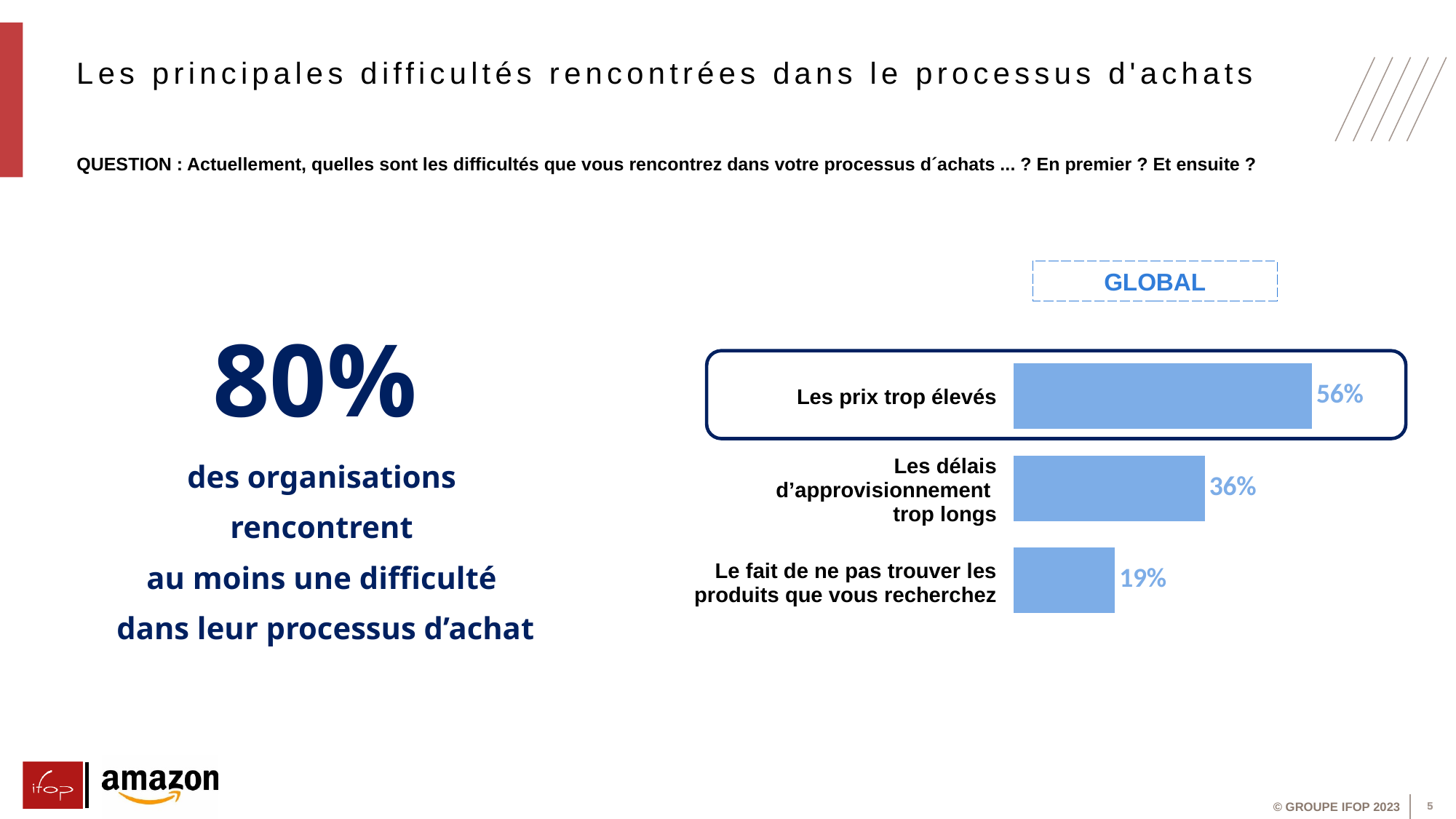
What is the value for "Les prix trop élevés"? 56% What is the value for "Le fait de ne pas trouver les produits que vous recherchez"? 19% What is the difference between the values for "Les prix trop élevés" and "Les délais d'approvisionnement trop longs"? 20% Which category has the lowest value? Le fait de ne pas trouver les produits que vous recherchez What kind of chart is shown on the slide? Bar chart What is the value for "Les délais d'approvisionnement trop longs"? 36% Which is larger: the value for "Les délais d'approvisionnement trop longs" or for "Le fait de ne pas trouver les produits que vous recherchez"? Les délais d'approvisionnement trop longs What is the difference between the values for "Les délais d'approvisionnement trop longs" and "Le fait de ne pas trouver les produits que vous recherchez"? 17% What label appears in the dashed box above the chart? GLOBAL How many categories are shown in the chart? 3 What percentage of organisations encounter at least one difficulty in their purchasing process, according to the large figure on the left? 80% Which category has the highest value? Les prix trop élevés